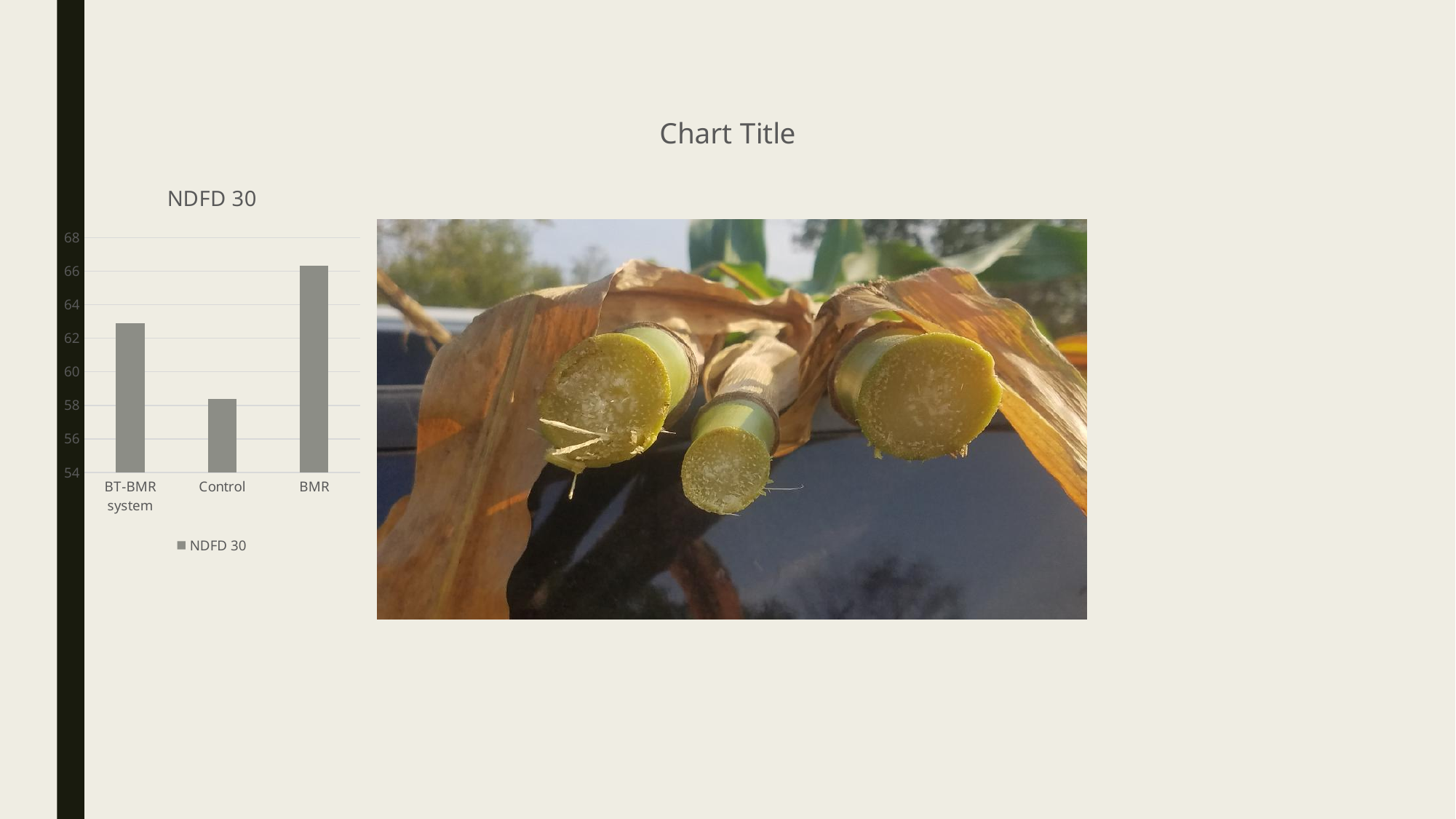
How many series does the legend list? 1 What series name appears in the legend? NDFD 30 Is the value for Control greater or less than 60? less Which category has the lowest value? Control Which category has the highest value? BMR What kind of chart is shown on the slide? bar chart How many categories are plotted in the chart? 3 Which is larger, the value for BT-BMR system or the value for Control? BT-BMR system Which is larger, the value for BMR or the value for BT-BMR system? BMR What is the title of the chart? NDFD 30 Is the value for BT-BMR system greater or less than 62? greater